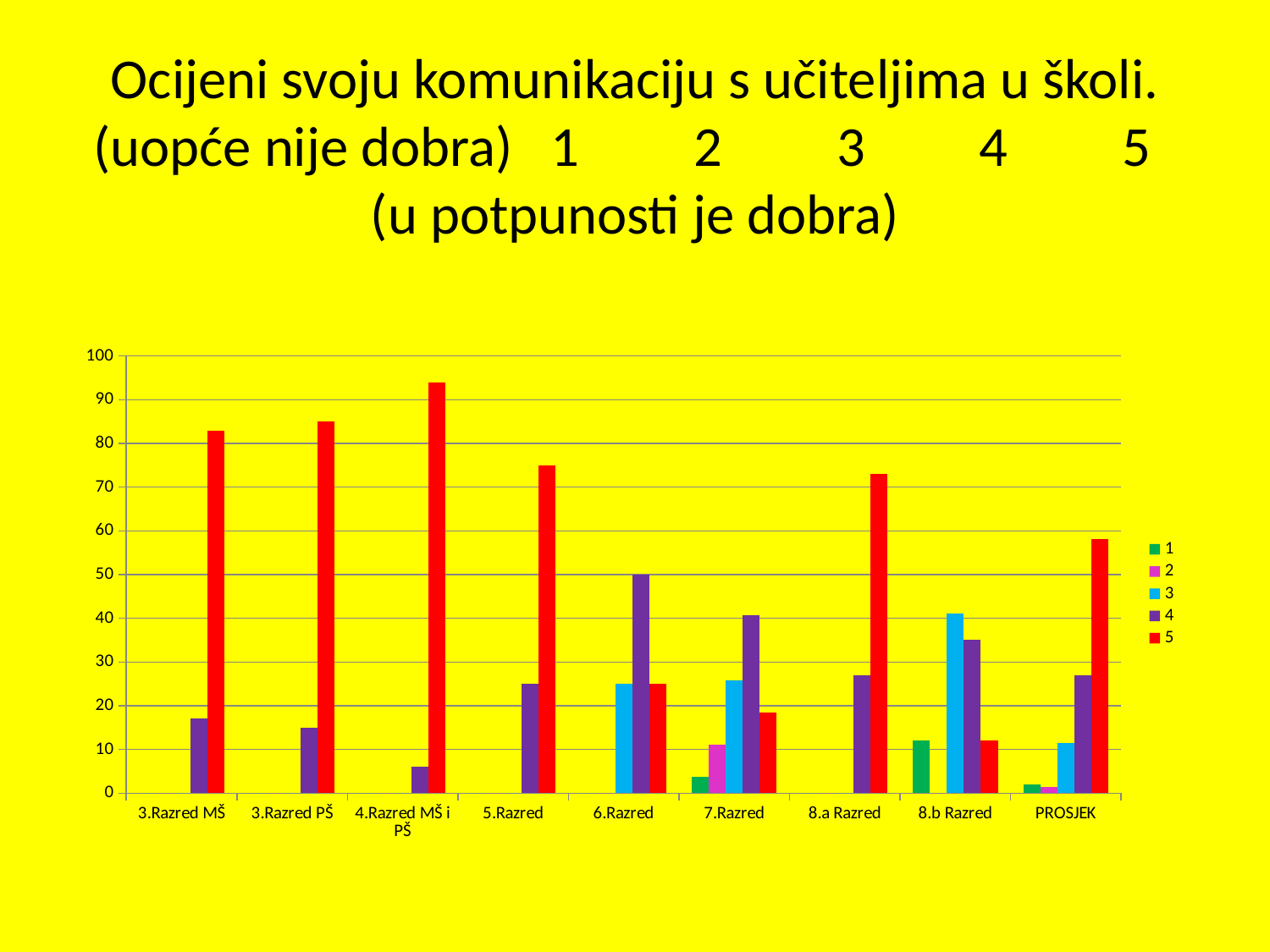
In 6.Razred, which is larger: the value for series 4 or the value for series 5? series 4 Is the value for series 4 in 7.Razred greater or less than 30? greater In 8.b Razred, which is larger: the value for series 3 or the value for series 4? series 3 Which category has the tallest bar for series 5? 4.Razred MŠ i PŠ How many series does the chart's legend list? 5 Is the value for series 5 in PROSJEK greater or less than 50? greater What kind of chart is shown on the slide? bar chart How many categories are shown along the x axis of the chart? 9 Is the value for series 5 in 3.Razred MŠ greater or less than 80? greater What colour are the bars for series 5 in the chart? red